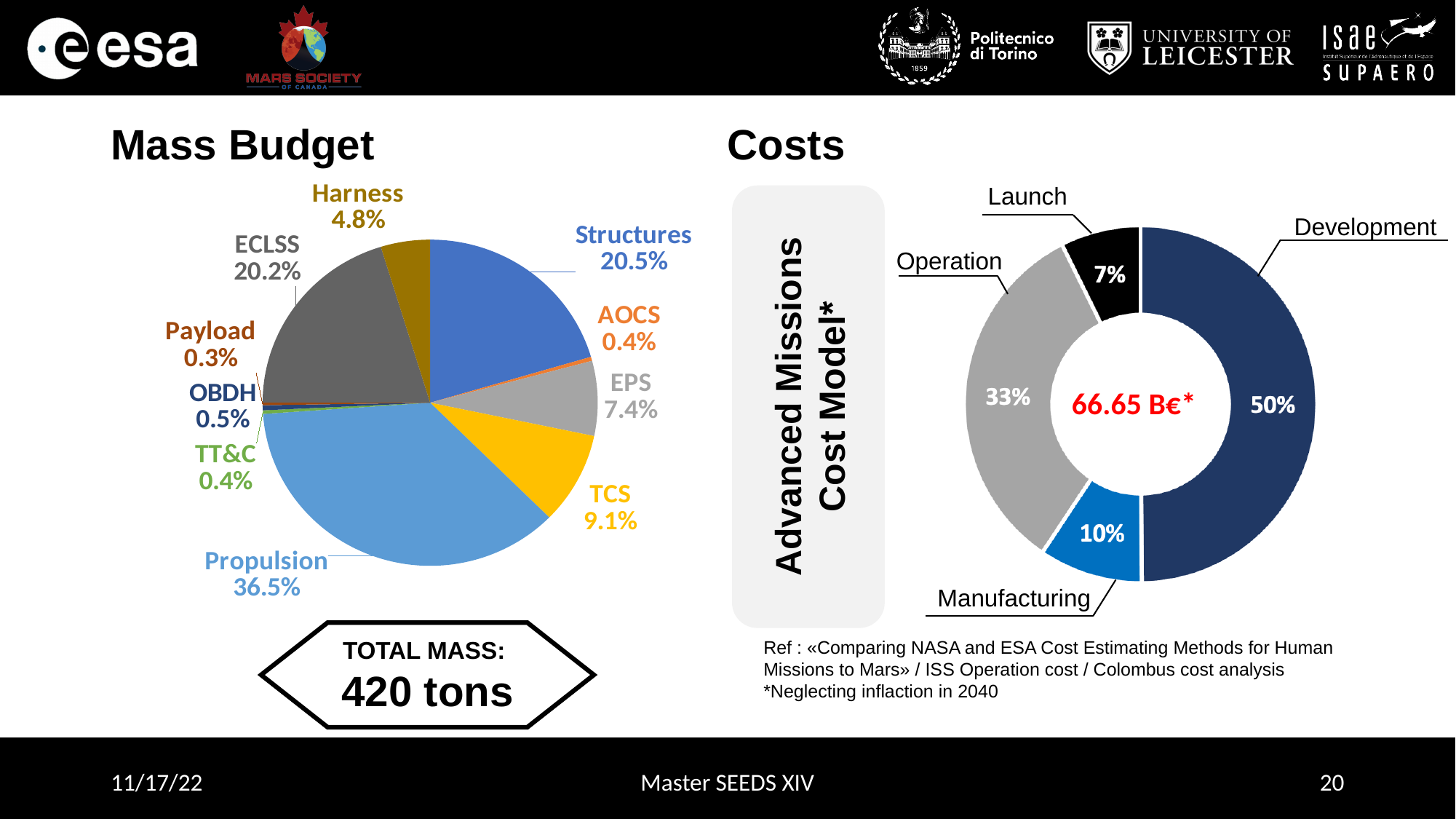
In the Mass Budget chart, what percentage is shown for ECLSS? 20.2% In the Costs chart, which category has the largest share? Development What type of chart is the Mass Budget chart? Pie chart In the Mass Budget chart, which category has the smallest share? Payload In the Mass Budget chart, what share of the mass is Propulsion? 36.5% How many categories does the Mass Budget pie chart show? 10 In the Costs chart, what percentage is shown for Operation? 33% In the Mass Budget chart, which is larger, the Harness share or the EPS share? EPS In the Mass Budget chart, what is the difference between the Structures share and the TCS share? 11.4% In the Mass Budget chart, which category has the largest share? Propulsion What total cost value is printed in the centre of the Costs chart? 66.65 B€* In the Costs chart, what is the difference between the Manufacturing share and the Launch share? 3%